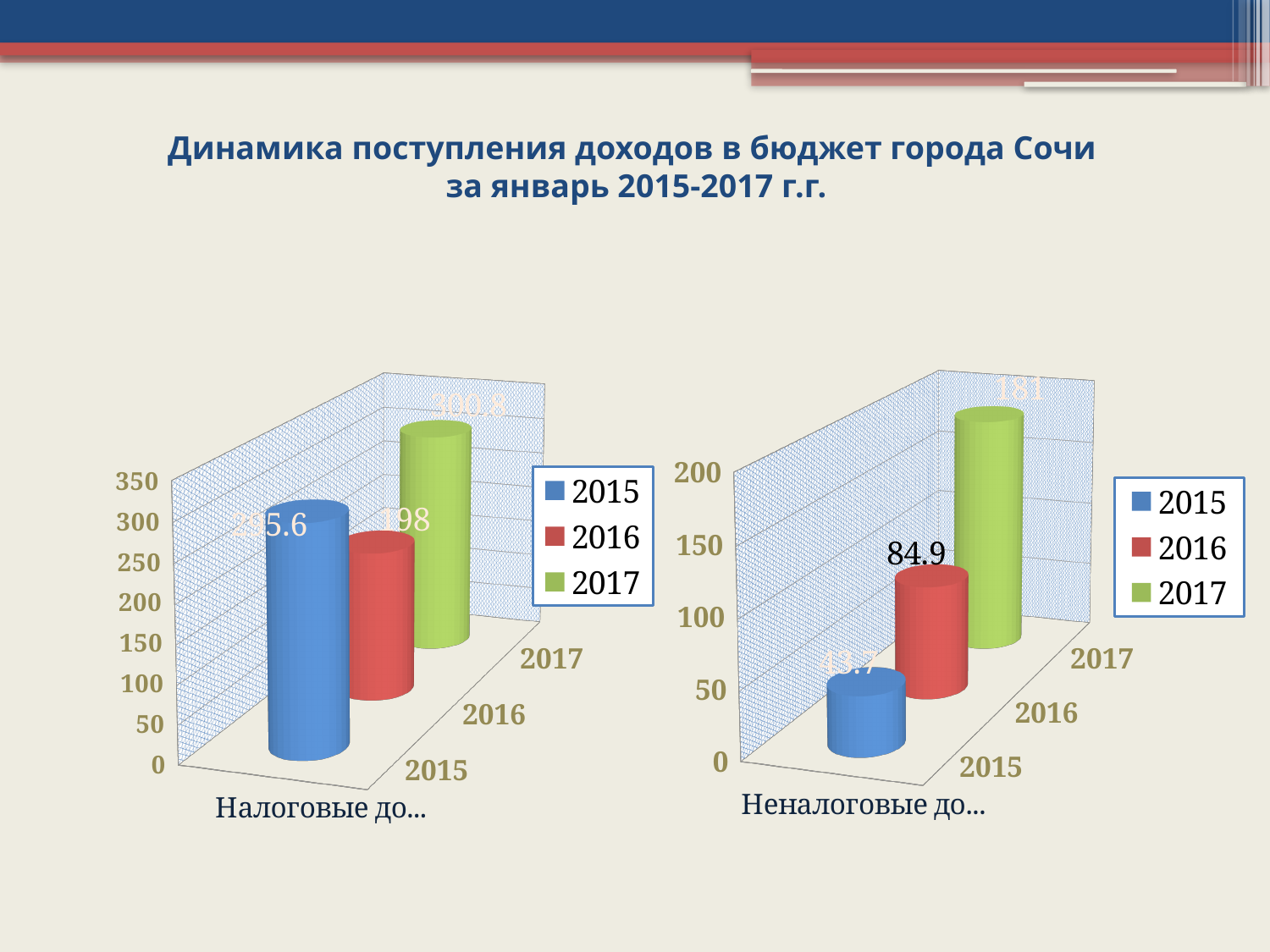
On the left chart, what is the value for 2015? 295.6 What type of chart is the left chart? bar chart On the left chart, which year has the lowest value? 2016 On the right chart, which year has the highest value? 2017 On the right chart, which year has the lowest value? 2015 On the right chart, what is the difference between the 2017 and 2016 values? 96.1 On the right chart, what is the value for 2017? 181 On the left chart, what is the value for 2016? 198 On the right chart, what is the value for 2016? 84.9 On the left chart, what is the value for 2017? 300.8 On the left chart, is the value for 2016 greater or less than 250? less How many series does the legend of the right chart list? 3